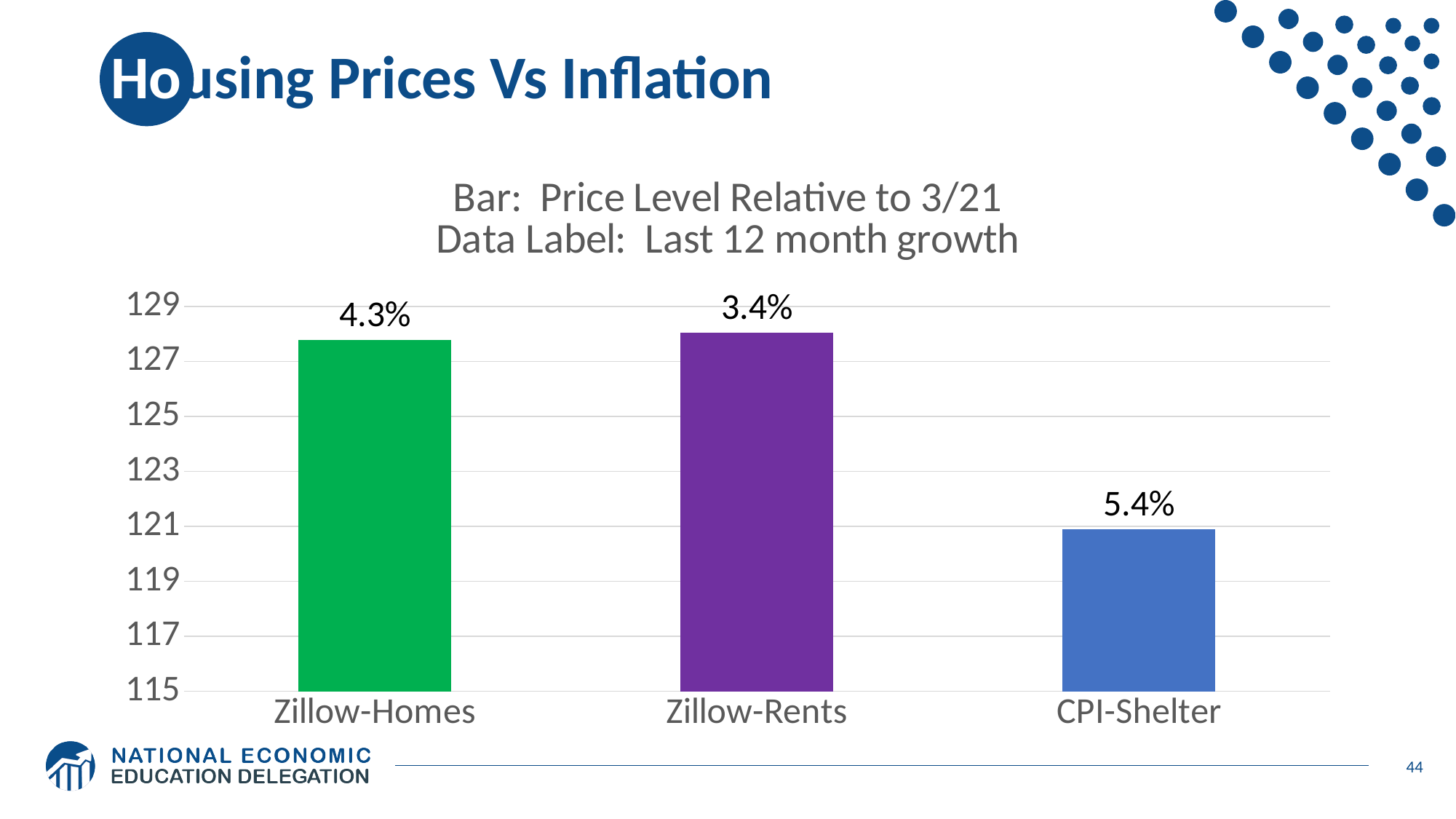
Which category has the lowest bar (price level relative to 3/21)? CPI-Shelter What type of chart is shown on the slide? Bar chart What is the data label shown above the CPI-Shelter bar? 5.4% What is the data label shown above the Zillow-Homes bar? 4.3% Which category has the highest last 12 month growth data label? CPI-Shelter What is the difference between the CPI-Shelter and Zillow-Rents data labels? 2.0% Which category has the lowest last 12 month growth data label? Zillow-Rents How many categories are shown on the chart? 3 Is the bar height for CPI-Shelter greater or less than 123? less Is the bar height for Zillow-Homes greater or less than 125? greater What is the data label shown above the Zillow-Rents bar? 3.4% Which has the larger data label, Zillow-Homes or CPI-Shelter? CPI-Shelter